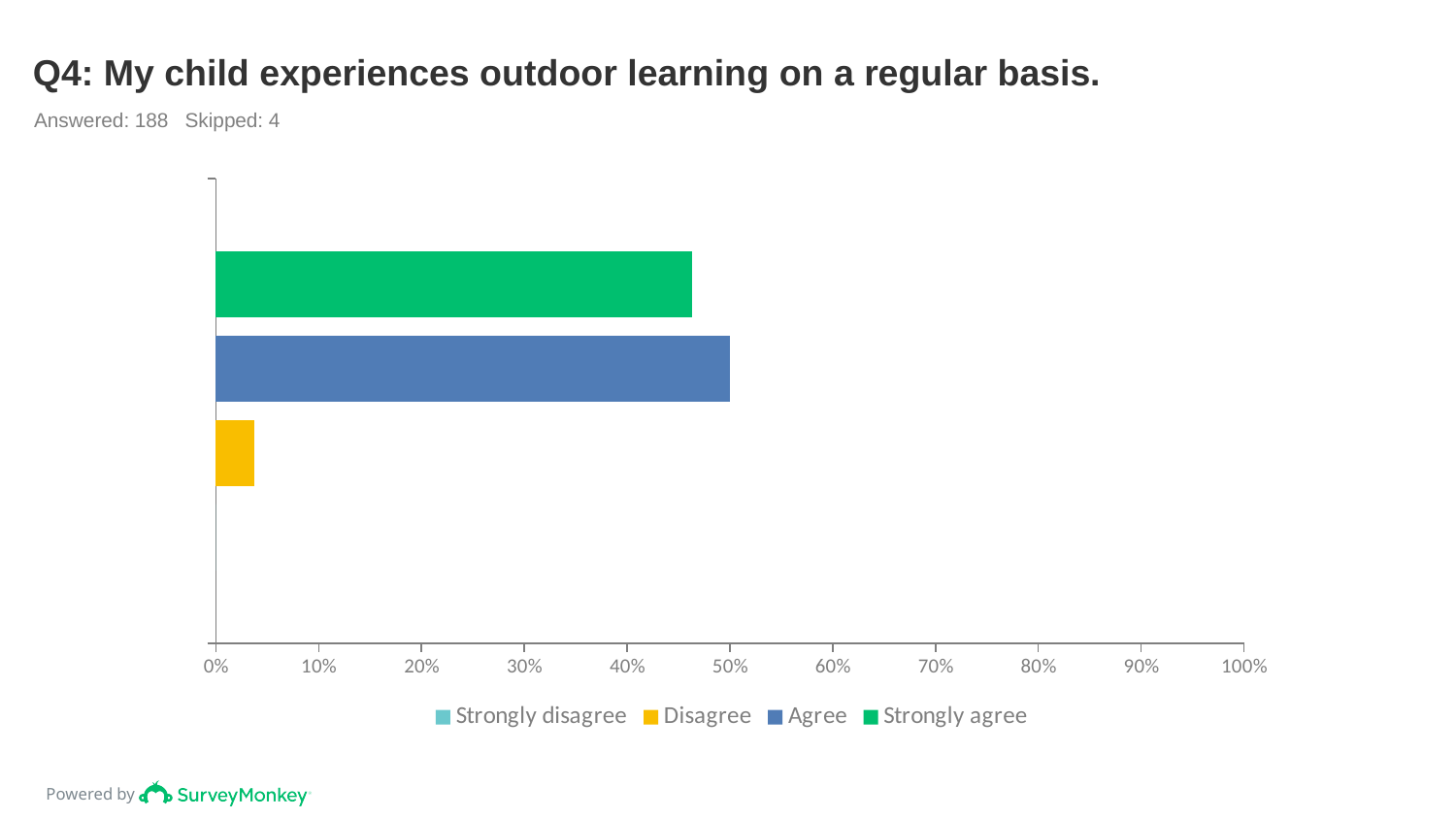
Is the value for Disagree greater or less than 10%? less Which is larger, the value for Disagree or the value for Strongly agree? Strongly agree How many series does the legend list? 4 Which is larger, the value for Agree or the value for Disagree? Agree Is the value for Agree greater or less than 40%? greater Which legend entry has no visible bar in the chart? Strongly disagree Is the value for Strongly agree greater or less than 40%? greater What kind of chart is shown on the slide? bar chart How many responses were answered according to the slide? 188 What colour is the bar for Disagree? yellow Which response has the longest bar? Agree